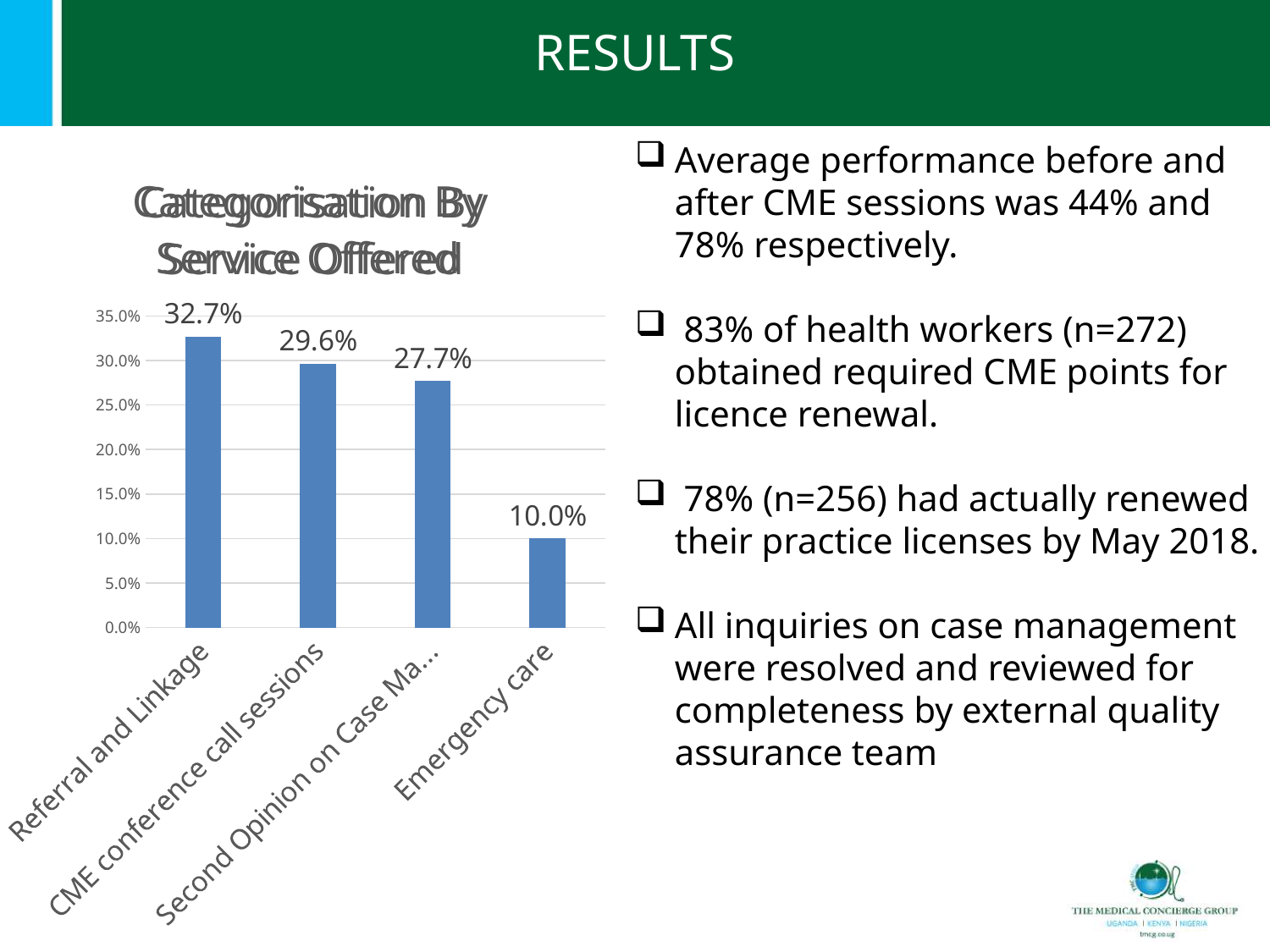
Which is larger, the value for CME conference call sessions or the value for Emergency care? CME conference call sessions How many categories are shown in the chart? 4 What is the value for Emergency care? 10.0% What is the title of the chart? Categorisation By Service Offered What is the difference between the values for Referral and Linkage and Emergency care? 22.7% What kind of chart is shown on the slide? Bar chart What is the value for CME conference call sessions? 29.6% Which category has the highest value? Referral and Linkage What is the value shown for the third bar from the left (Second Opinion on Case Ma...)? 27.7% Which category has the lowest value? Emergency care What is the difference between the values for Referral and Linkage and CME conference call sessions? 3.1% What is the value for Referral and Linkage? 32.7%